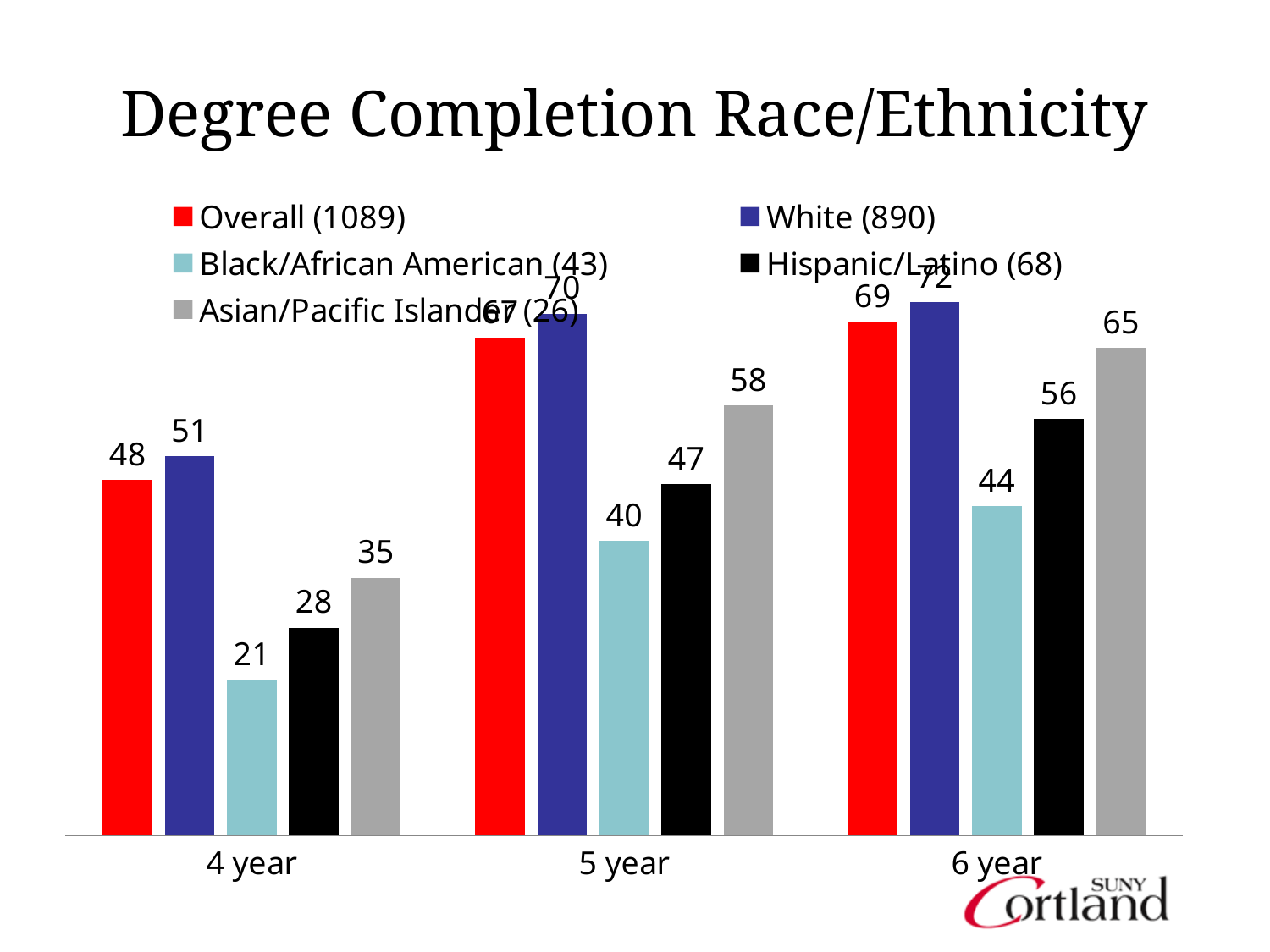
What is the value for Hispanic/Latino in the 4 year category? 28 How many series does the legend list? 5 What kind of chart is shown on the slide? Bar chart Which is larger in the 6 year category: Hispanic/Latino or Black/African American? Hispanic/Latino What is the value for White in the 4 year category? 51 Do the Overall values rise or fall from 4 year to 6 year? Rise What is the value for Black/African American in the 5 year category? 40 Which series has the lowest value in the 4 year category? Black/African American (43) How many categories are shown on the x axis? 3 What is the difference between the Asian/Pacific Islander value and the Hispanic/Latino value in the 5 year category? 11 What is the value for Asian/Pacific Islander in the 6 year category? 65 Which series has the highest value in the 6 year category? White (890)